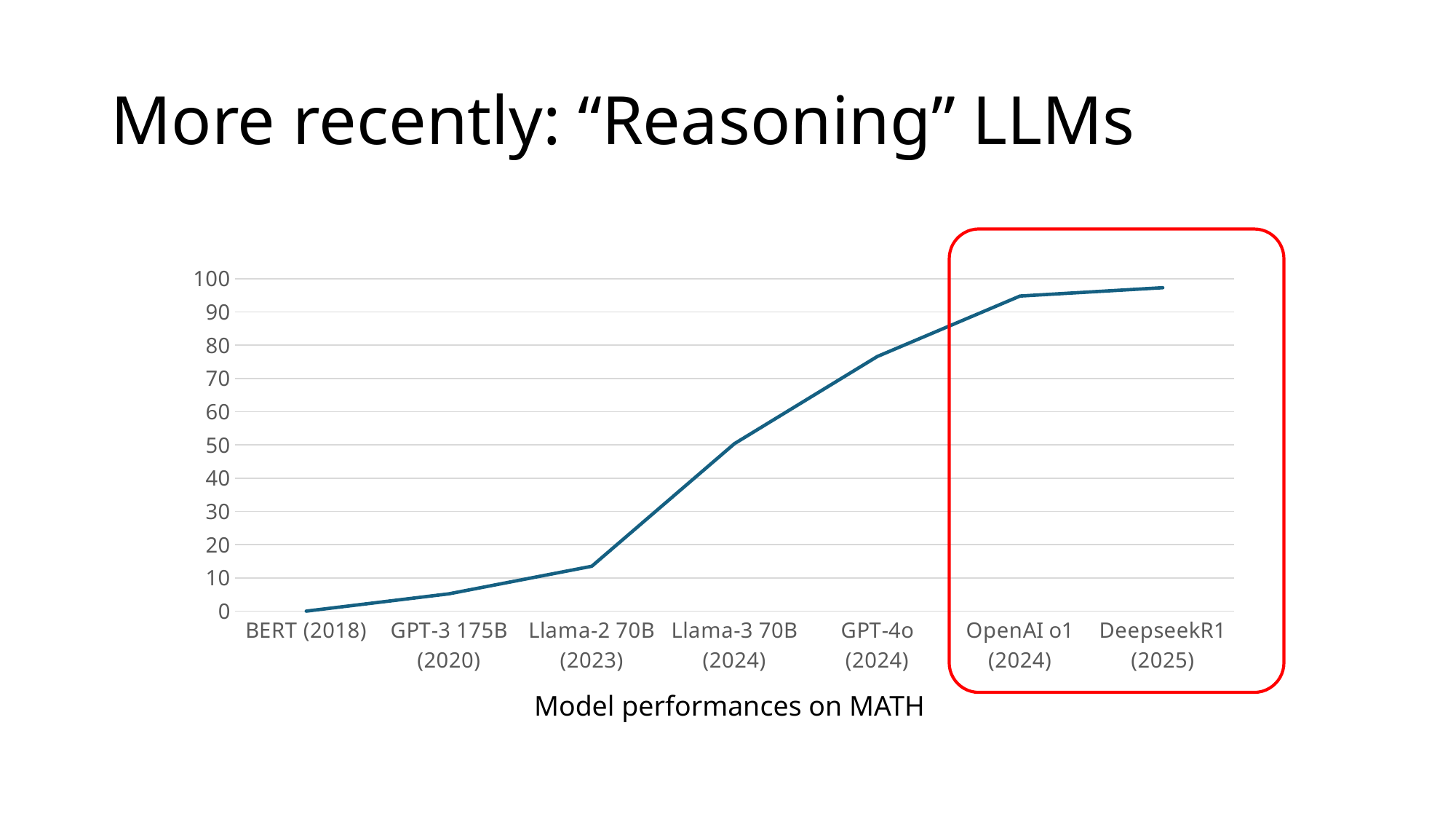
What kind of chart is shown on the slide? line chart What caption appears below the x axis of the chart? Model performances on MATH What is the value for BERT (2018)? 0 How many models are plotted along the x axis? 7 Do the values rise or fall from BERT (2018) to DeepseekR1 (2025)? rise Which two models are enclosed by the red box on the chart? OpenAI o1 (2024) and DeepseekR1 (2025) Which is larger, the value for GPT-4o (2024) or the value for Llama-3 70B (2024)? GPT-4o (2024) Is the value for OpenAI o1 (2024) greater or less than 90? greater Is the value for Llama-2 70B (2023) greater or less than 20? less Which model has the lowest value on the chart? BERT (2018) Is the value for GPT-4o (2024) greater or less than 70? greater